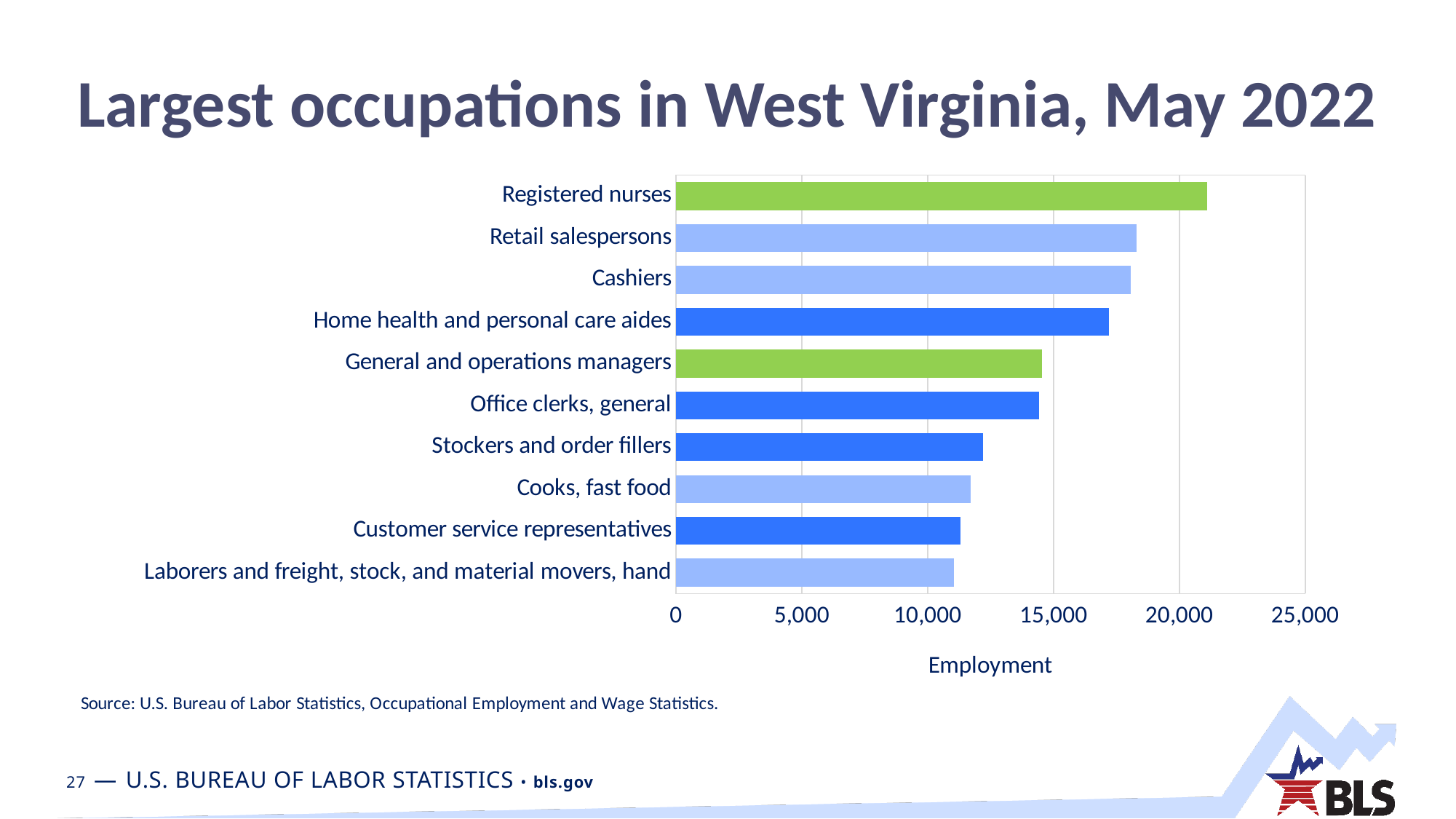
Is the employment value for Stockers and order fillers greater or less than 10,000? greater What type of chart is shown on the slide? bar chart Is the employment value for Registered nurses greater or less than 20,000? greater Which has higher employment, Stockers and order fillers or Customer service representatives? Stockers and order fillers Is the employment value for Home health and personal care aides greater or less than 15,000? greater How many occupations are shown in the chart? 10 Which has higher employment, Cashiers or Office clerks, general? Cashiers What is the label on the horizontal axis of the chart? Employment Which occupation has the highest employment in the chart? Registered nurses